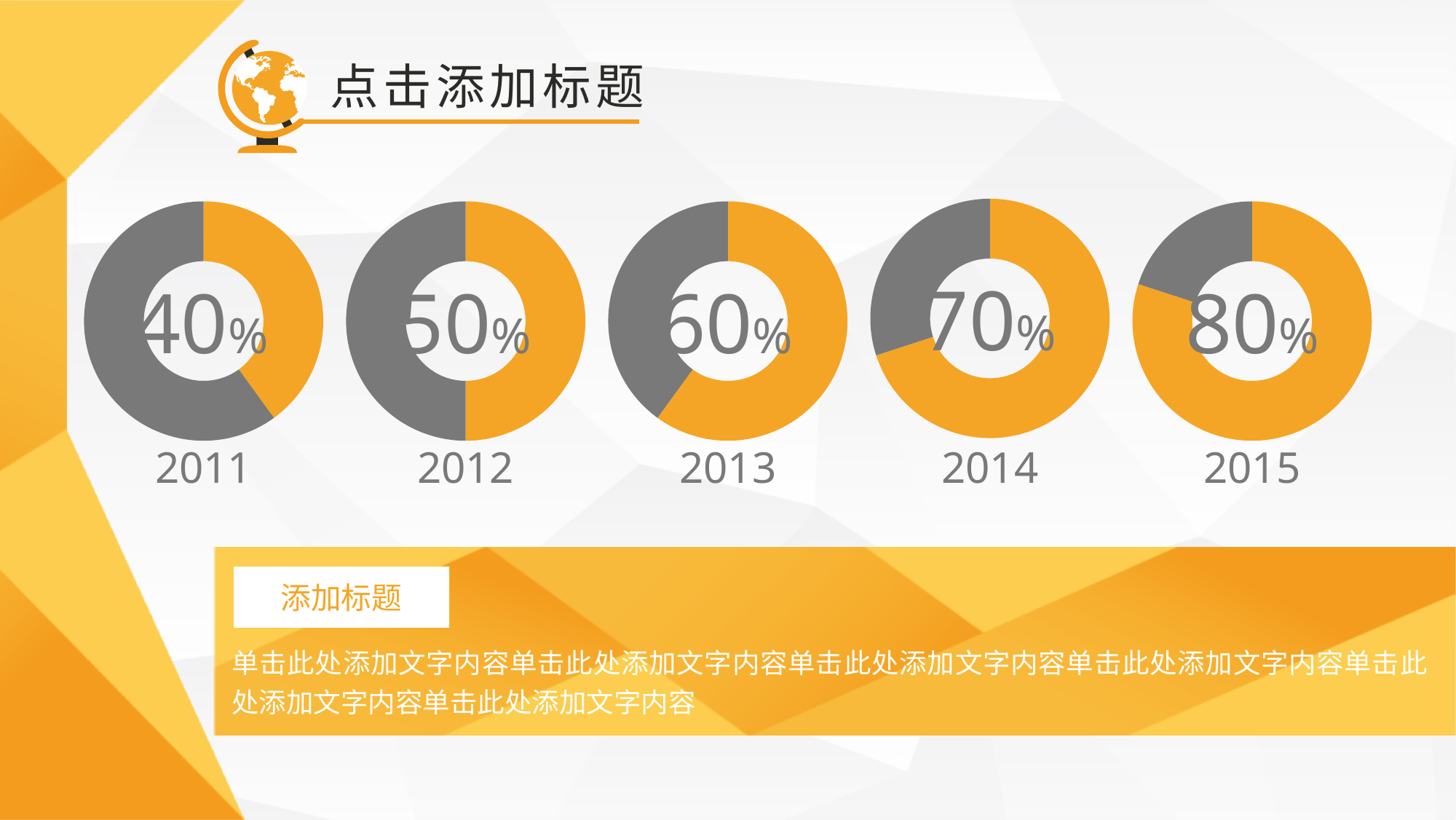
What value is shown in the donut chart labelled 2013? 60% Which year's donut chart shows the highest percentage? 2015 Which is larger, the value in the 2013 donut chart or the value in the 2011 donut chart? 2013 What colour represents the filled percentage in each donut chart? Orange What is the difference between the value in the 2014 donut chart and the value in the 2012 donut chart? 20% Which year's donut chart shows the lowest percentage? 2011 What kind of chart is used for each year on the slide? Donut chart What value is shown in the donut chart labelled 2015? 80% How many donut charts are shown on the slide? 5 In the 2012 donut chart, what share of the ring is orange? 50% What value is shown in the donut chart labelled 2011? 40% Do the percentages rise or fall from 2011 to 2015 across the donut charts? Rise